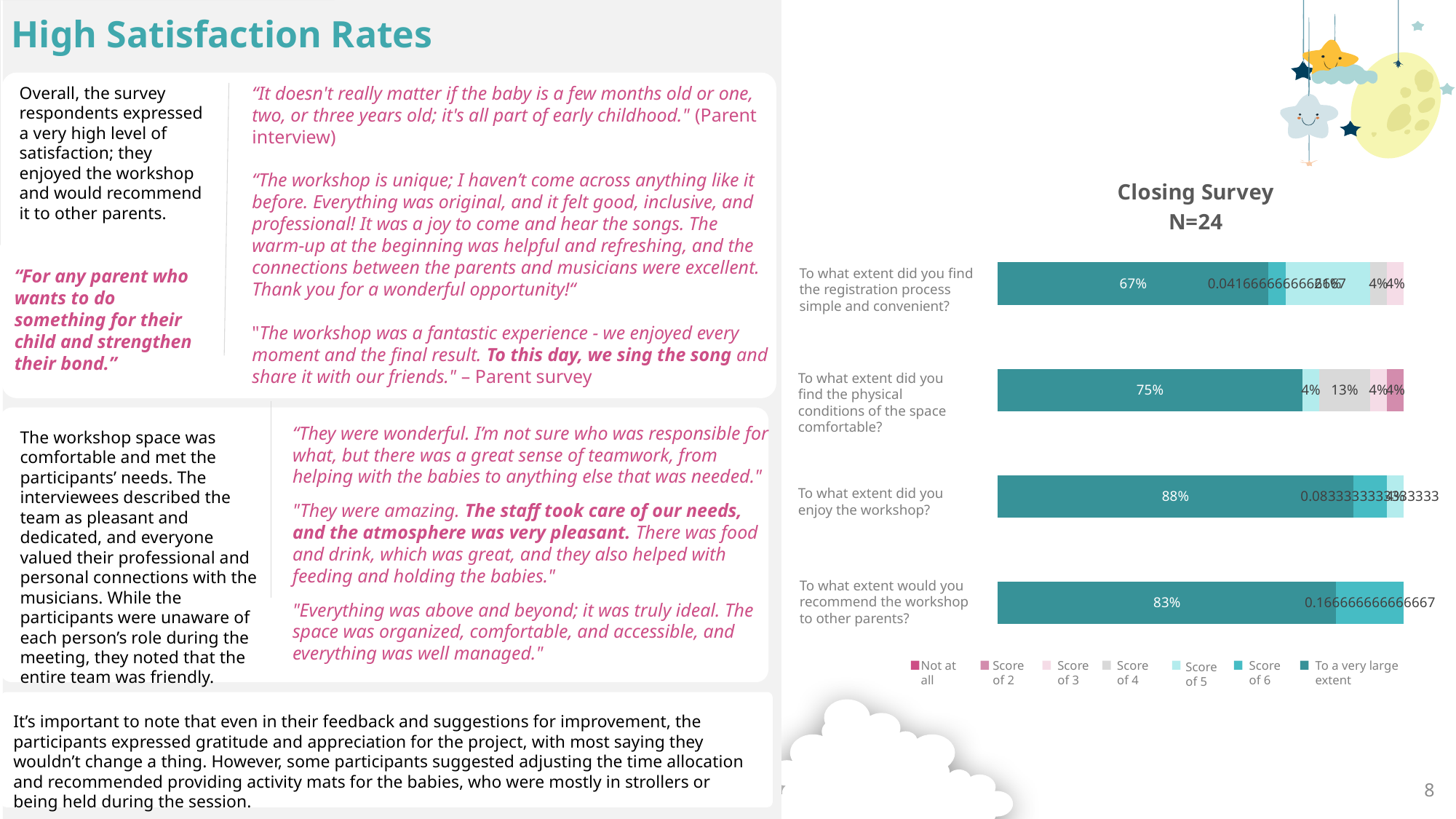
In the Closing Survey chart, what share answered 'To a very large extent' for finding the physical conditions of the space comfortable? 75% What kind of chart is the Closing Survey chart? Stacked bar chart How many series does the legend of the Closing Survey chart list? 7 In the Closing Survey chart, what share answered 'To a very large extent' for finding the registration process simple and convenient? 67% What sample size (N) is stated in the title of the Closing Survey chart? N=24 In the Closing Survey chart, what is the difference between the 'To a very large extent' shares for enjoying the workshop and for the registration process? 21 percentage points In the Closing Survey chart, what share answered 'To a very large extent' for recommending the workshop to other parents? 83% In the Closing Survey chart, which question has the highest 'To a very large extent' share? To what extent did you enjoy the workshop? In the Closing Survey chart, what share answered 'To a very large extent' for 'To what extent did you enjoy the workshop?' 88% How many survey questions (categories) are plotted in the Closing Survey chart? 4 In the Closing Survey chart, which question has the lowest 'To a very large extent' share? To what extent did you find the registration process simple and convenient? In the Closing Survey chart, which has the larger 'To a very large extent' share: recommending the workshop or the physical conditions of the space? Recommending the workshop to other parents